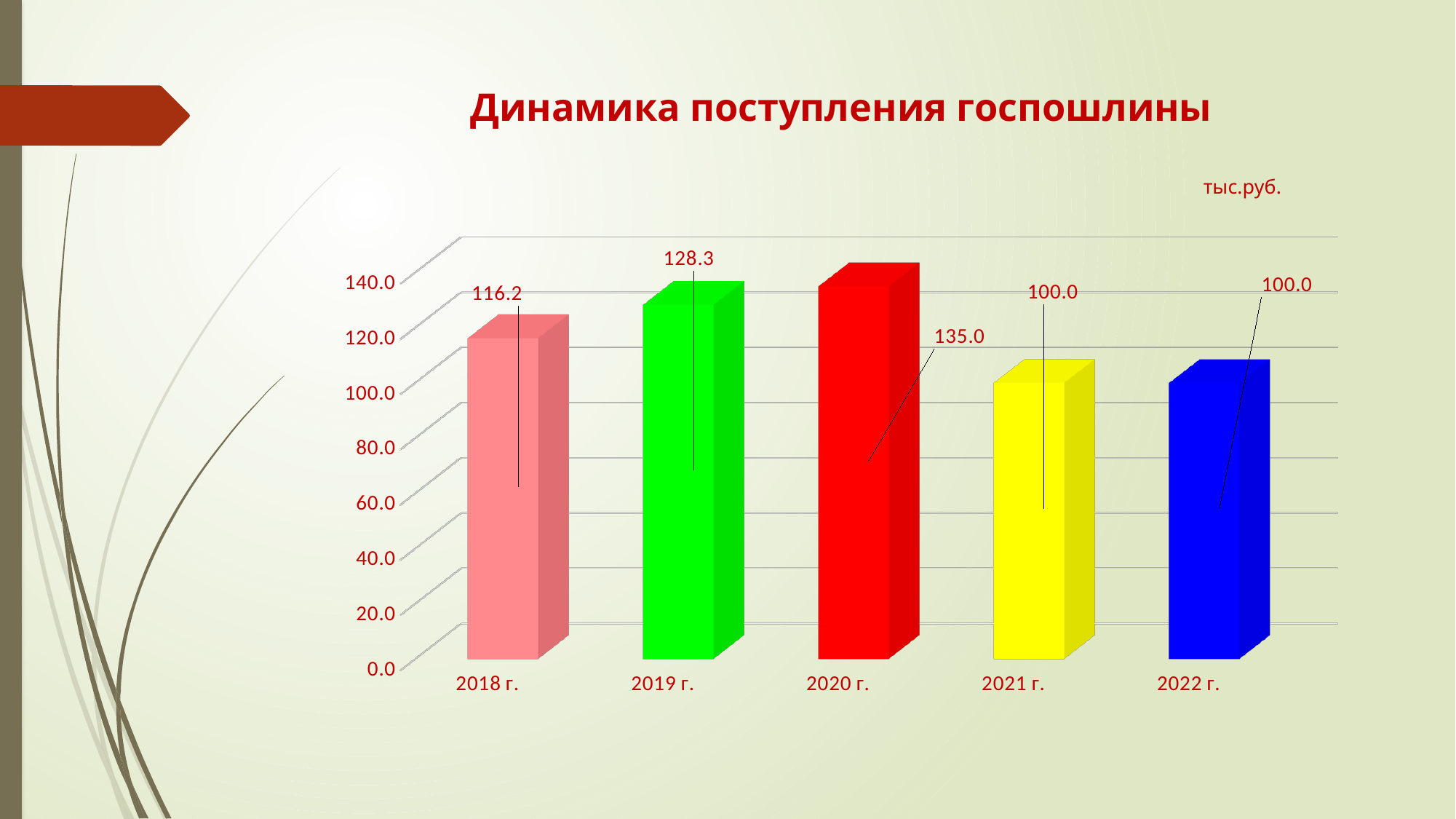
What is the title of the chart? Динамика поступления госпошлины How many years are shown on the x axis? 5 What is the value for 2020 г.? 135.0 What is the difference between the values for 2020 г. and 2018 г.? 18.8 What kind of chart is shown on the slide? bar chart What is the value for 2021 г.? 100.0 What is the value for 2018 г.? 116.2 Which year has the highest value? 2020 г. Which is larger, the value for 2019 г. or the value for 2022 г.? 2019 г. Is the value for 2020 г. greater or less than 120.0? greater What is the difference between the values for 2019 г. and 2021 г.? 28.3 What is the value for 2019 г.? 128.3